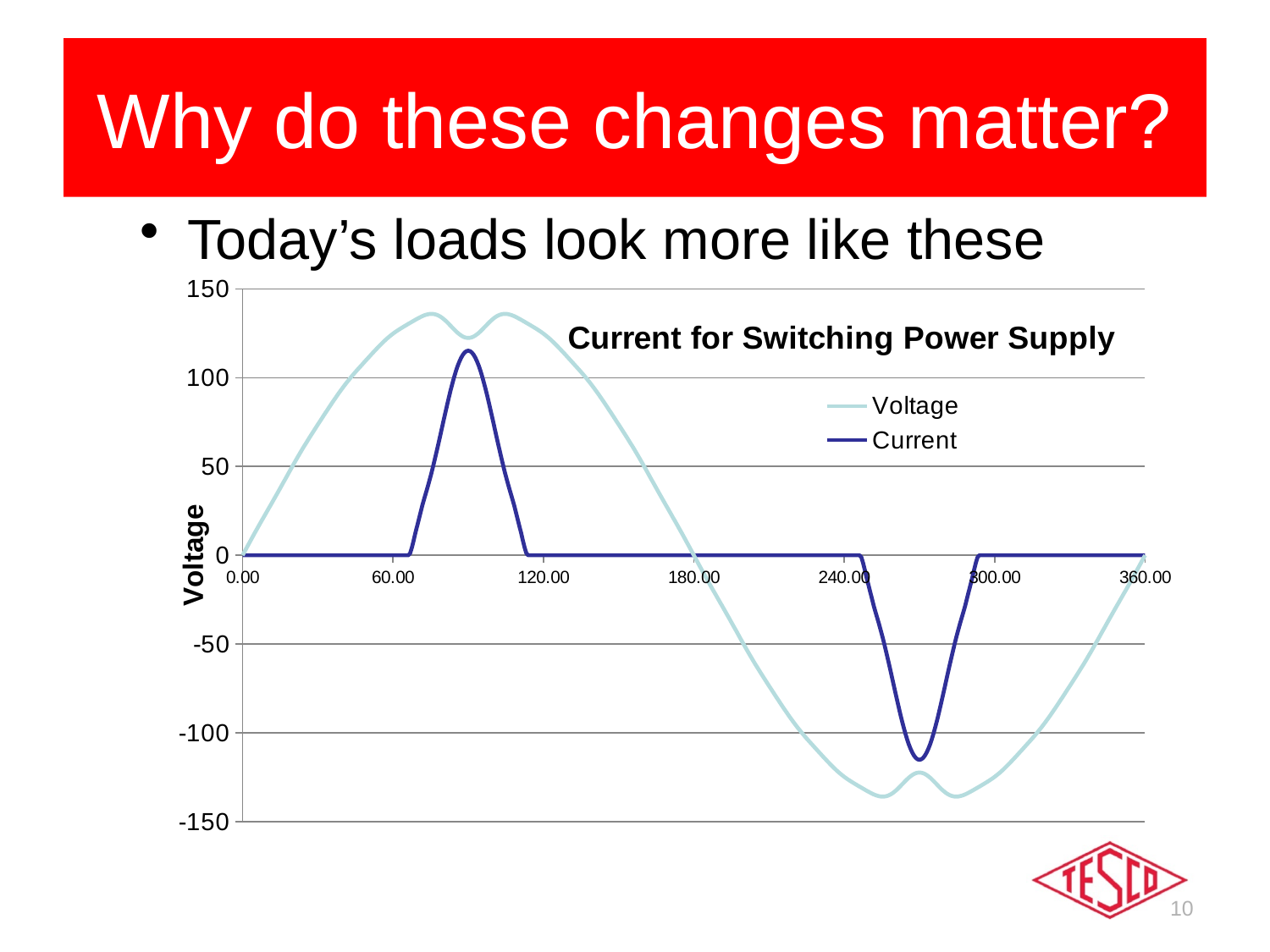
How many series does the chart legend list? 2 What are the two series named in the chart legend? Voltage and Current What is the Current value at x = 0.00? 0 What kind of chart is shown on the slide? line chart What is the title of the chart? Current for Switching Power Supply Is the Current value at x = 60.00 greater or less than 50? less Is the Voltage value at x = 240.00 greater or less than -100? less What is the Voltage value at x = 180.00? 0 Is the peak value of the Voltage series greater or less than 100? greater How many tick labels are shown on the x axis? 7 Which series reaches a higher maximum value, Voltage or Current? Voltage